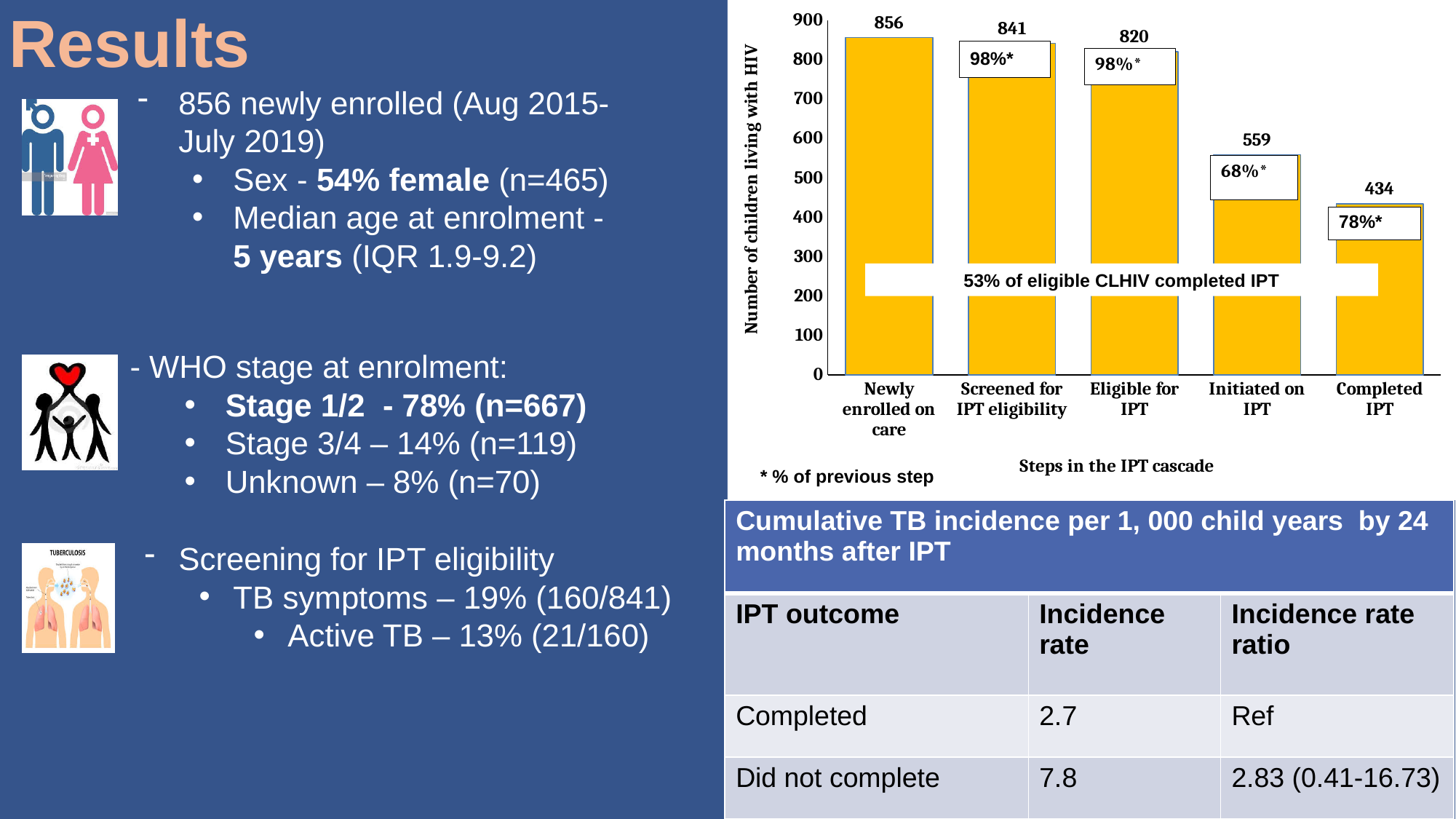
Which is larger: the number eligible for IPT or the number initiated on IPT? Eligible for IPT What is the value for 'Completed IPT' in the chart? 434 Which step in the IPT cascade has the highest number of children? Newly enrolled on care What is the value for 'Eligible for IPT' in the chart? 820 Do the values rise or fall along the x axis from 'Newly enrolled on care' to 'Completed IPT'? Fall Which step in the IPT cascade has the lowest number of children? Completed IPT What is the difference between the number screened for IPT eligibility and the number initiated on IPT? 282 How many children were newly enrolled on care according to the chart? 856 What is the label of the y axis of the chart? Number of children living with HIV What type of chart is shown on the slide? Bar chart How many steps in the IPT cascade are shown on the x axis of the chart? 5 Is the value for 'Initiated on IPT' greater or less than 500? greater